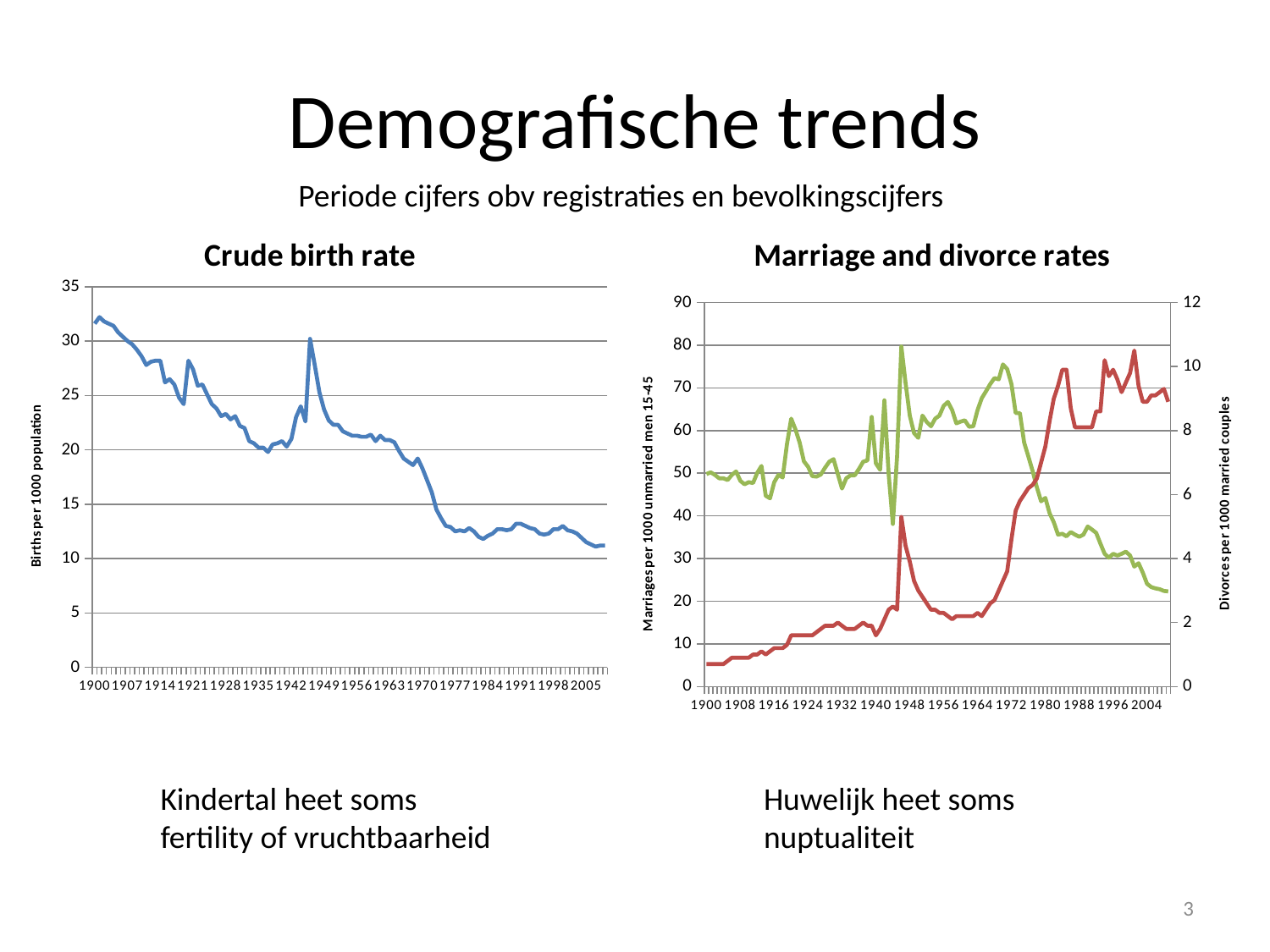
In the Crude birth rate chart, is the value for 2005 greater or less than 15? less In the Marriage and divorce rates chart, is the marriages (green line) value for 1900 greater or less than 40 on the left axis? greater In the Marriage and divorce rates chart, does the divorces (red line) series overall rise or fall from 1900 to 2004? rise In the Crude birth rate chart, is the value for 1900 greater or less than 30? greater In the Marriage and divorce rates chart, does the marriages (green line) series rise or fall from 1972 to 2004? fall What is the label of the right-hand y-axis of the Marriage and divorce rates chart? Divorces per 1000 married couples In the Crude birth rate chart, do the values overall rise or fall from 1900 to 2005? fall In the Crude birth rate chart, which year has the larger value, 1900 or 2005? 1900 What kind of chart is the Marriage and divorce rates chart? line chart What is the y-axis label of the Crude birth rate chart? Births per 1000 population What kind of chart is the Crude birth rate chart? line chart